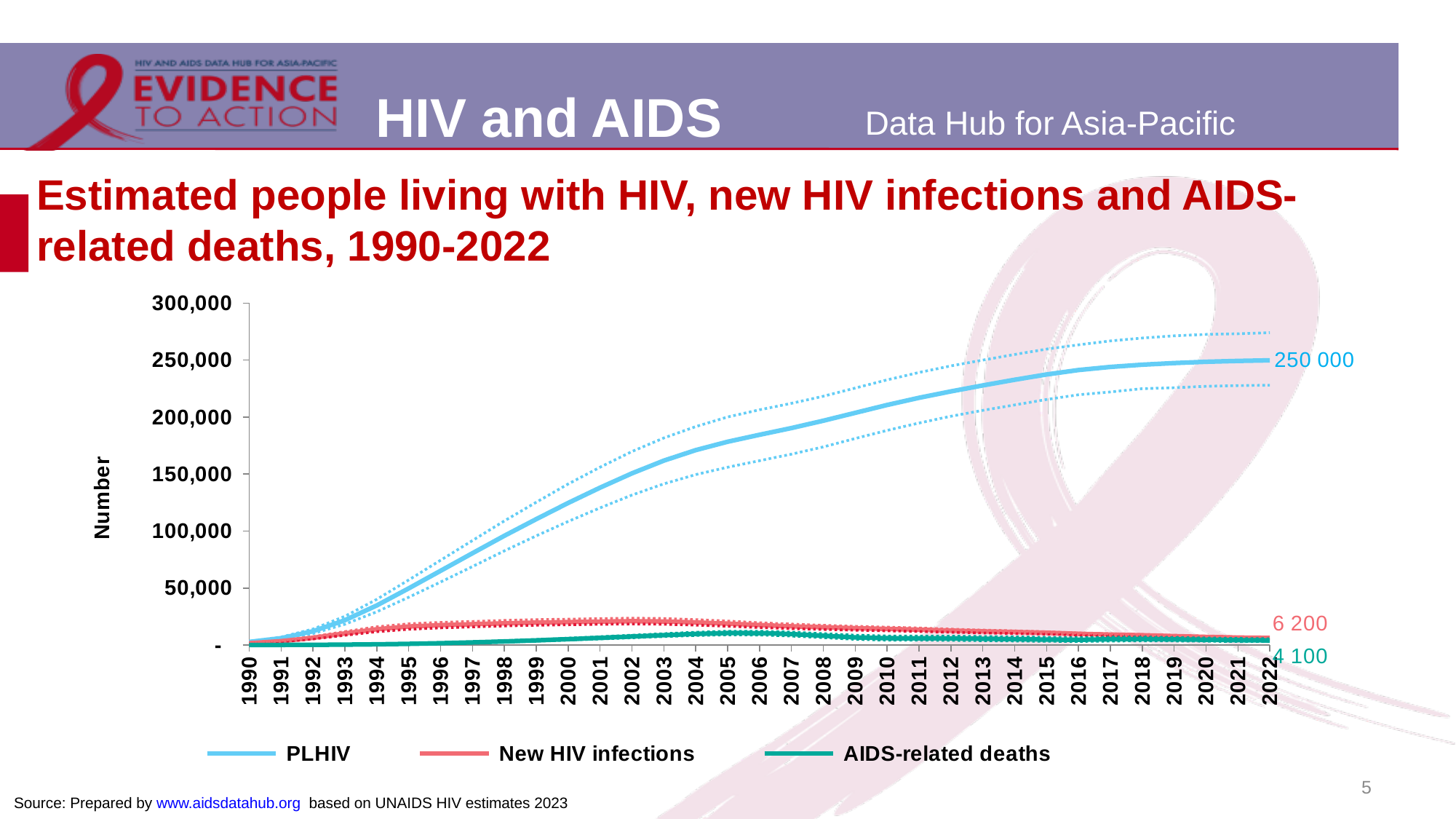
What kind of chart is shown on the slide? Line chart Which series has the lowest value in 2022? AIDS-related deaths What is the value for PLHIV in 2022? 250 000 What is the value for New HIV infections in 2022? 6 200 Is the value for PLHIV in 2010 greater or less than 150,000? greater Does the PLHIV series rise or fall from 1990 to 2022? Rise In 2022, which is larger: PLHIV or New HIV infections? PLHIV What is the value for AIDS-related deaths in 2022? 4 100 Which series has the highest value in 2022? PLHIV What is the difference between New HIV infections and AIDS-related deaths in 2022? 2 100 Is the value for PLHIV in 1995 greater or less than 100,000? less How many series does the legend list? 3